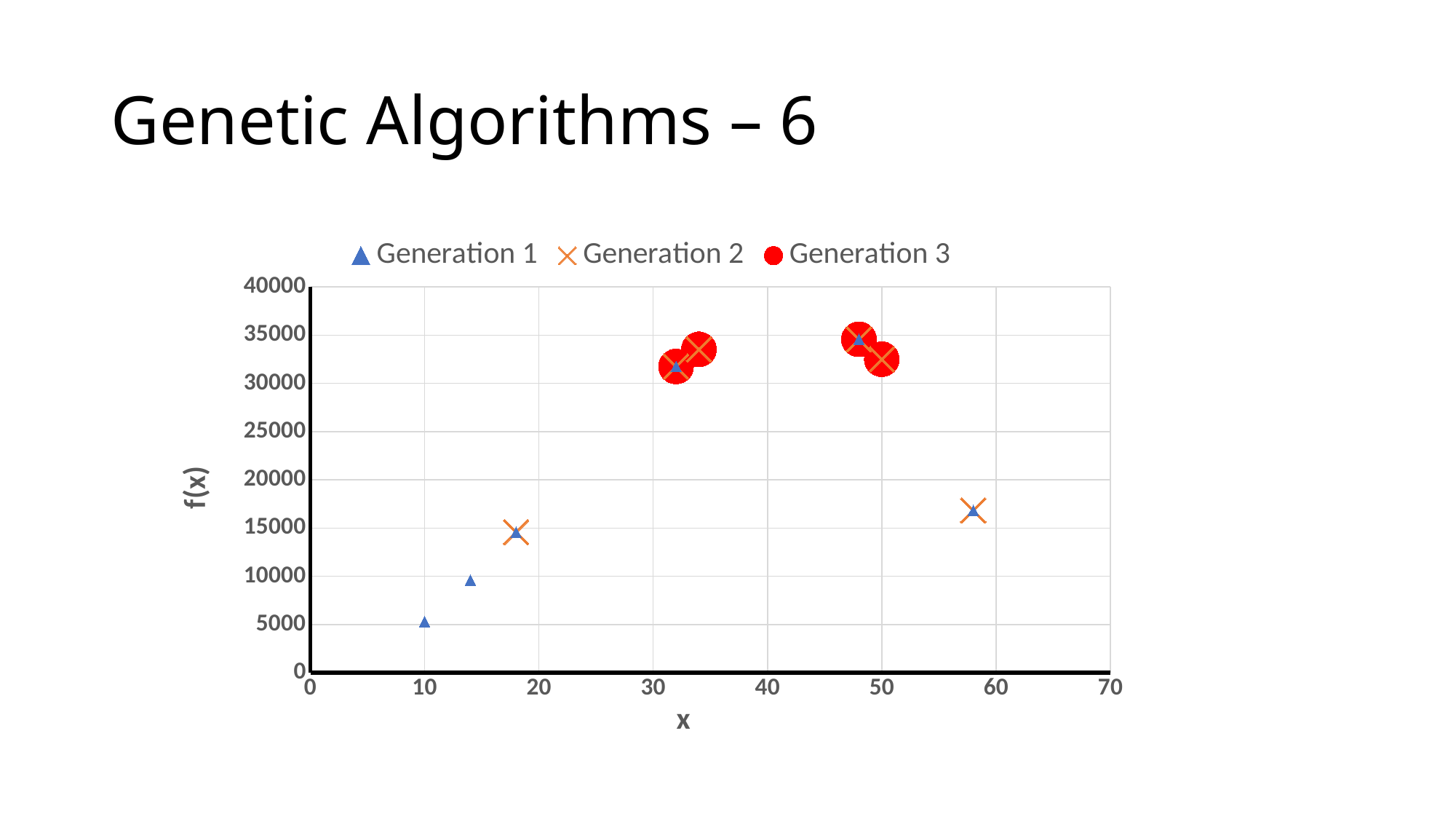
How many series does the legend list? 3 Are the f(x) values of the Generation 3 points greater or less than 30000? greater What kind of chart is shown on the slide? scatter chart How many Generation 2 points are plotted? 6 Is the Generation 1 point at x = 10 higher or lower in f(x) than the Generation 1 point near x = 14? lower Is the f(x) value of the Generation 1 point at x = 10 greater or less than 10000? less Is the f(x) value of the Generation 2 point near x = 18 greater or less than 20000? less What is the highest value shown on the f(x) axis? 40000 What are the names of the series in the legend? Generation 1, Generation 2, Generation 3 What is the label on the vertical axis? f(x)